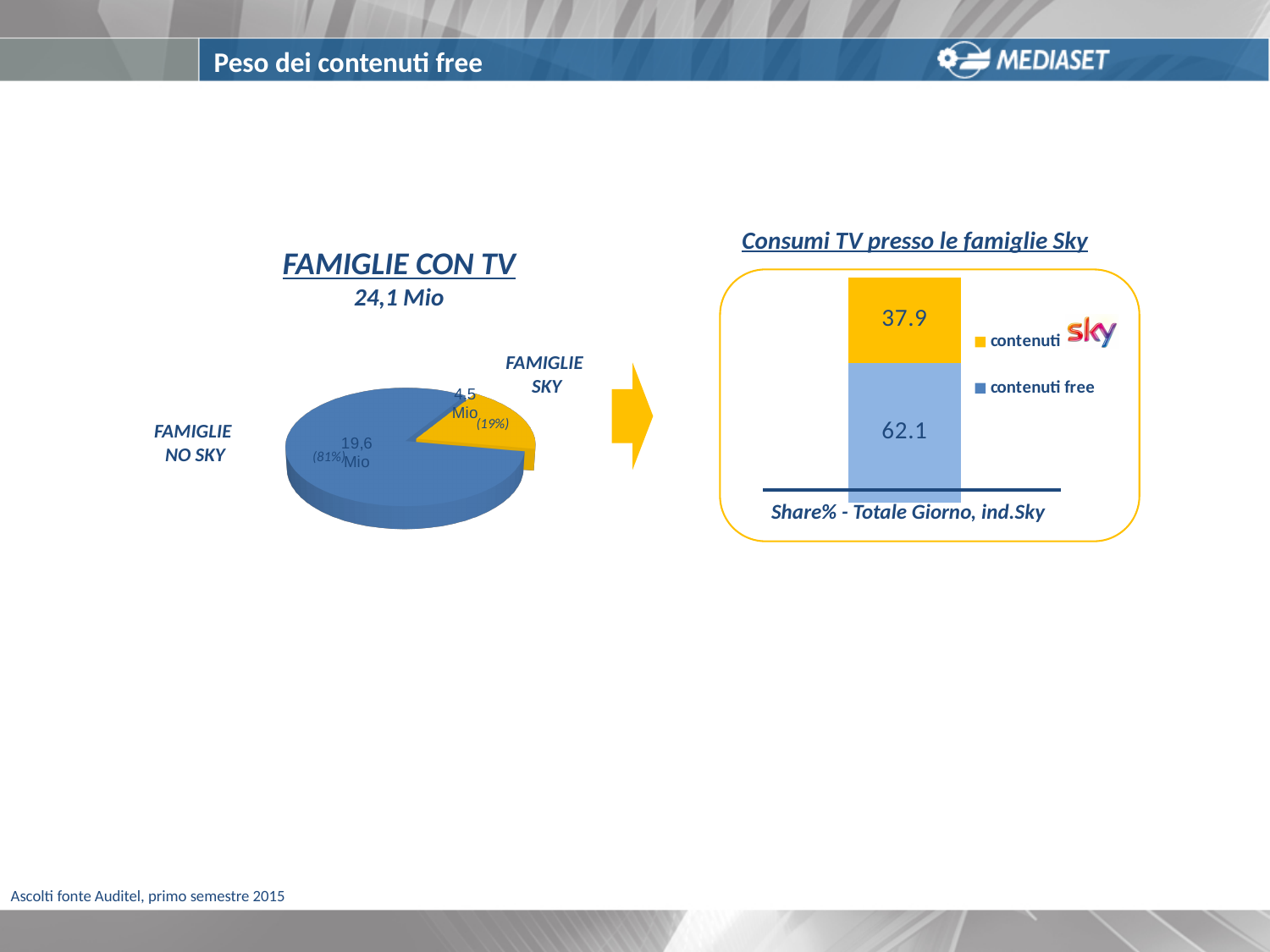
In the pie chart 'FAMIGLIE CON TV', how many slices are there? 2 In the pie chart 'FAMIGLIE CON TV', which slice is the largest? FAMIGLIE NO SKY In the chart 'Consumi TV presso le famiglie Sky', what is the difference between contenuti free and contenuti sky? 24.2 In the chart 'Consumi TV presso le famiglie Sky', which is larger: contenuti free or contenuti sky? contenuti free In the pie chart 'FAMIGLIE CON TV', what share of the pie does FAMIGLIE SKY represent? 19% In the chart 'Consumi TV presso le famiglie Sky', what is the value for contenuti sky? 37.9 In the pie chart 'FAMIGLIE CON TV', what is the value for FAMIGLIE SKY? 4,5 Mio In the chart 'Consumi TV presso le famiglie Sky', what is the value for contenuti free? 62.1 In the chart 'Consumi TV presso le famiglie Sky', how many series does the legend list? 2 What type of chart is 'FAMIGLIE CON TV'? Pie chart In the pie chart 'FAMIGLIE CON TV', what share of the pie does FAMIGLIE NO SKY represent? 81% In the pie chart 'FAMIGLIE CON TV', what is the value for FAMIGLIE NO SKY? 19,6 Mio